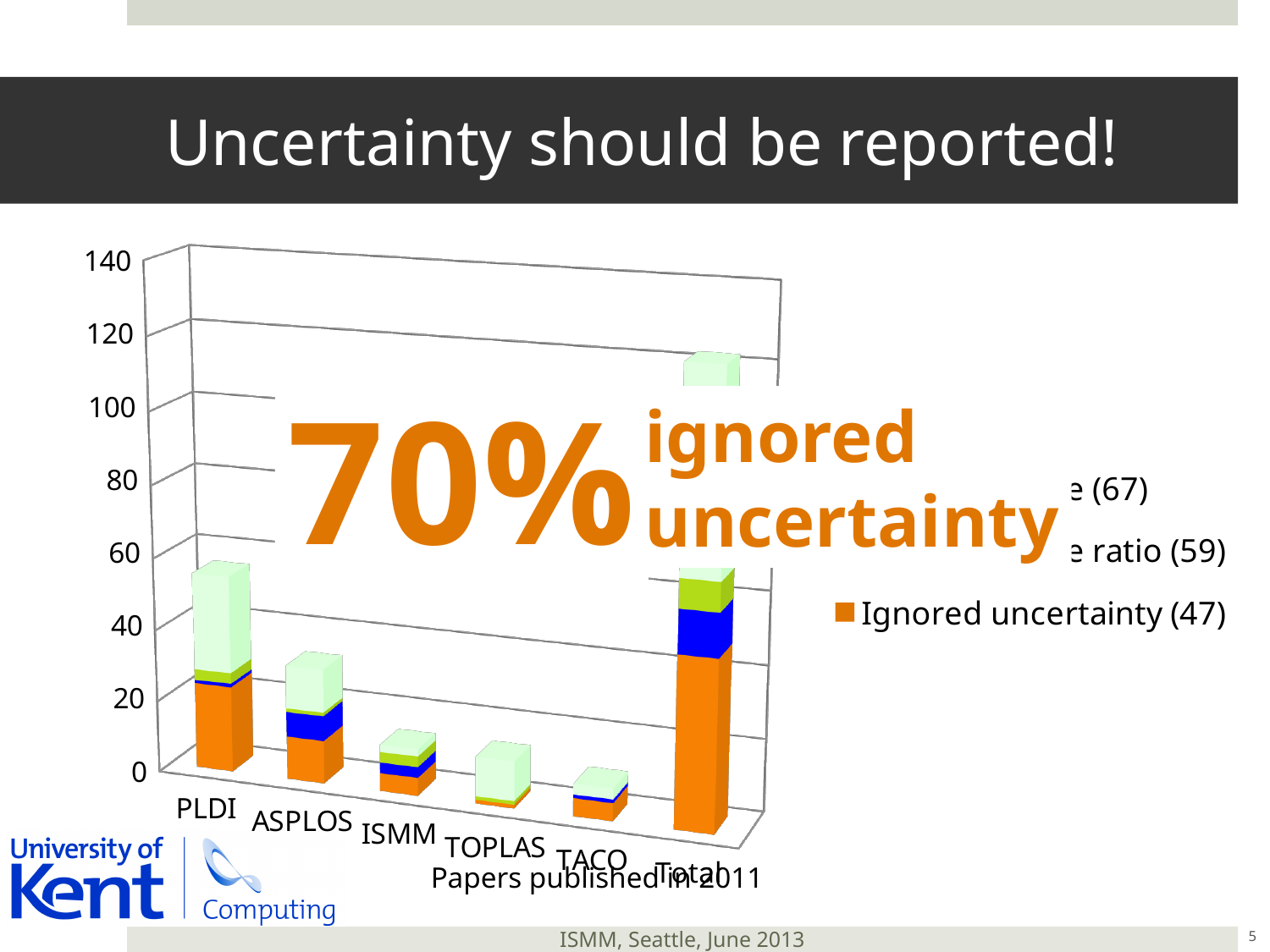
What is the title of the x axis of the chart? Papers published in 2011 Which legend entry is shown in orange? Ignored uncertainty (47) Is the total height of the ASPLOS bar greater or less than 40? less Is the total height of the PLDI bar greater or less than 40? greater Is the total height of the Total bar greater or less than 100? greater Which bar is taller, PLDI or ASPLOS? PLDI Which category has the tallest bar in the chart? Total What kind of chart is shown on the slide? stacked bar chart How many categories are shown along the x axis of the chart? 6 Which category has the shortest bar in the chart? TACO